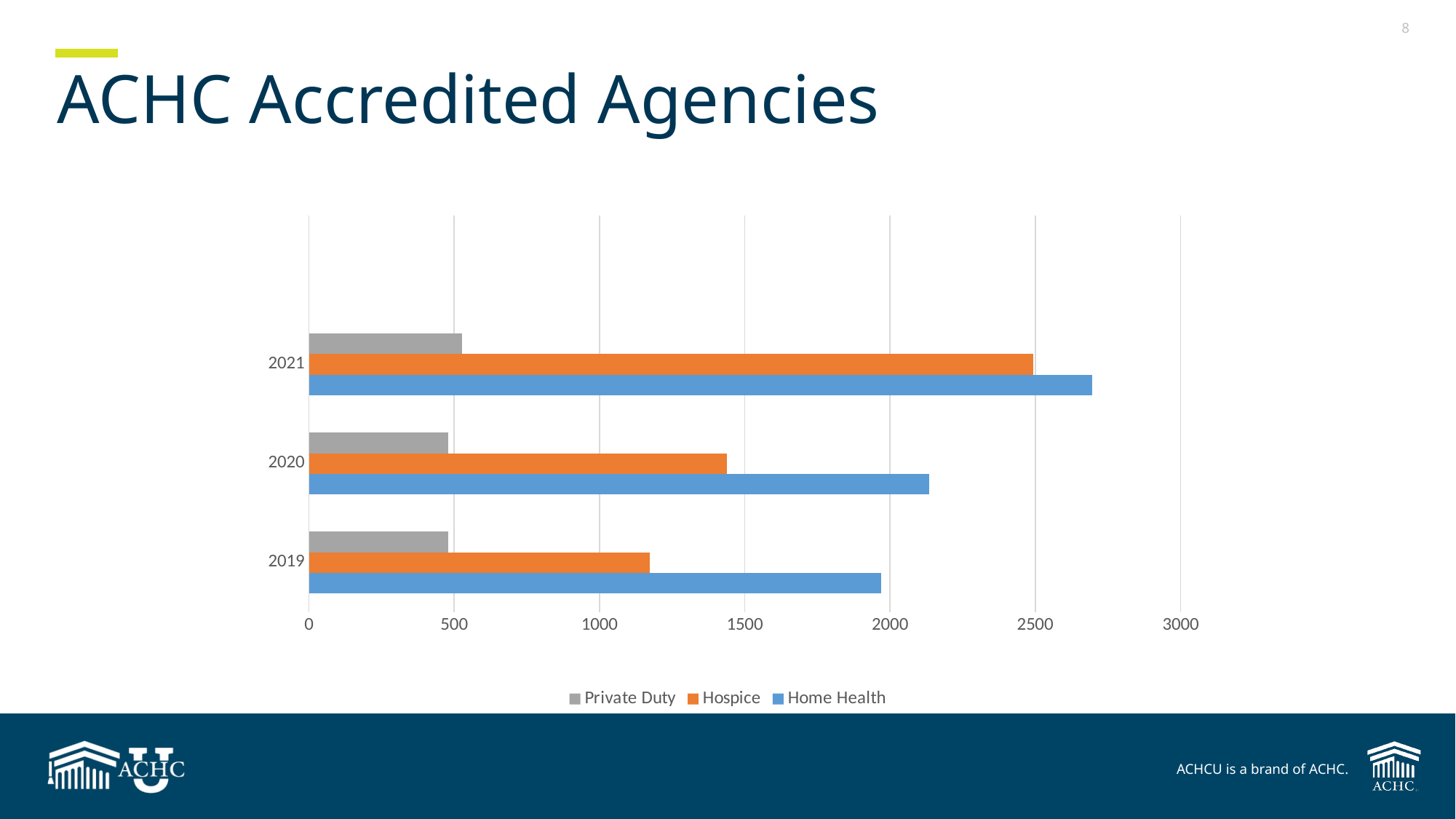
Which year has the lowest Hospice value? 2019 In 2019, which is larger: Home Health or Hospice? Home Health What is the title of the slide containing the chart? ACHC Accredited Agencies What kind of chart is shown on the slide? bar chart Is the Hospice value for 2019 greater or less than 1000? greater Is the Hospice value for 2020 greater or less than 1500? less Is the Home Health value for 2020 greater or less than 2000? greater Which year has the highest Home Health value? 2021 Do the Hospice values rise or fall from 2019 to 2021? rise How many series does the legend list? 3 How many years are shown on the chart? 3